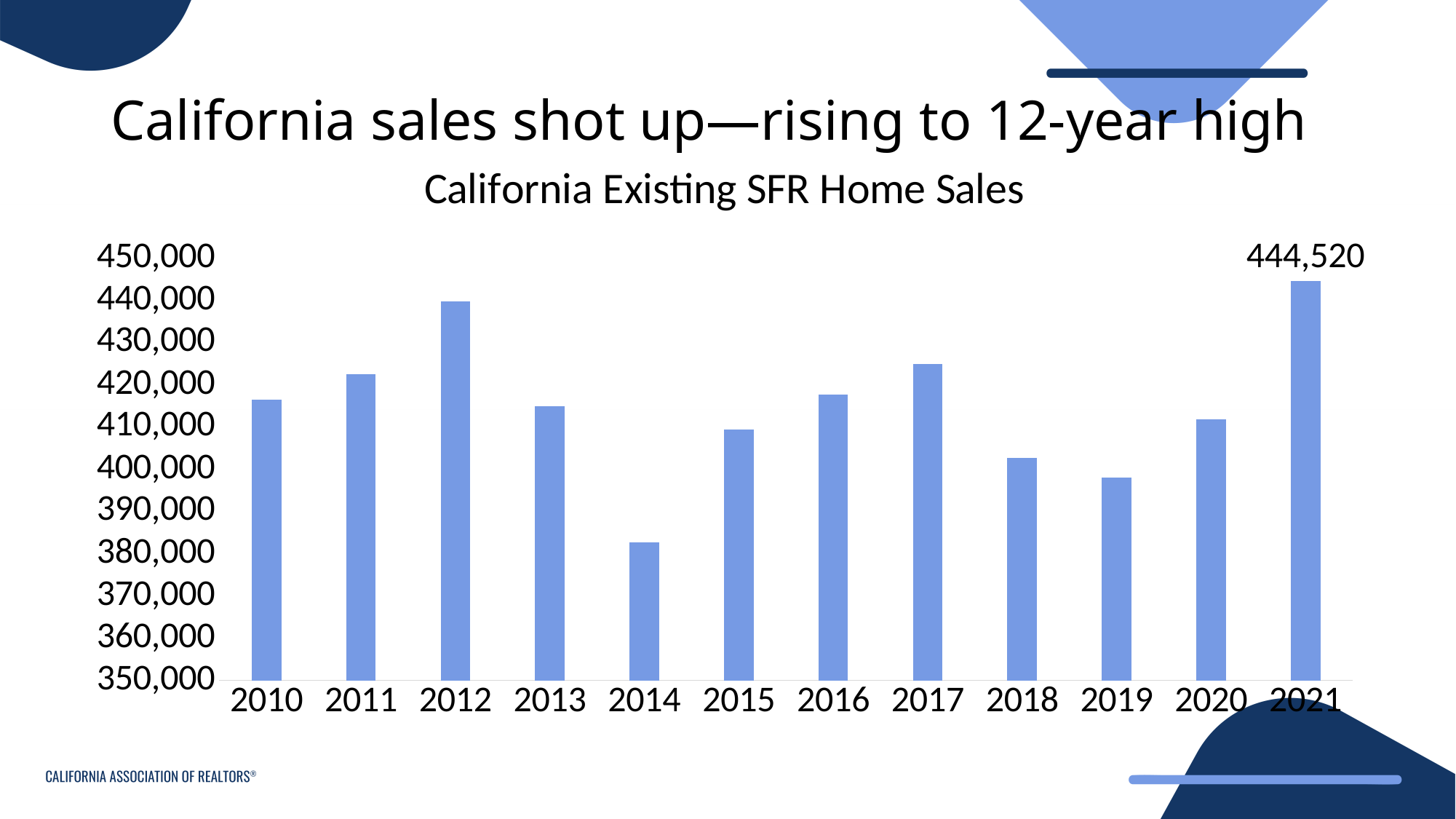
Which year has the lowest value in the chart? 2014 What is the title of the chart? California Existing SFR Home Sales Which year has the larger value, 2014 or 2018? 2018 Which year has the highest value in the chart? 2021 What kind of chart is shown on the slide? Bar chart Is the value for 2012 greater or less than 430,000? greater How many years are shown on the x axis of the chart? 12 What is the value for 2021 in the California Existing SFR Home Sales chart? 444,520 Which year has the larger value, 2012 or 2017? 2012 Do the values rise or fall from 2012 to 2014? fall Is the value for 2014 greater or less than 390,000? less